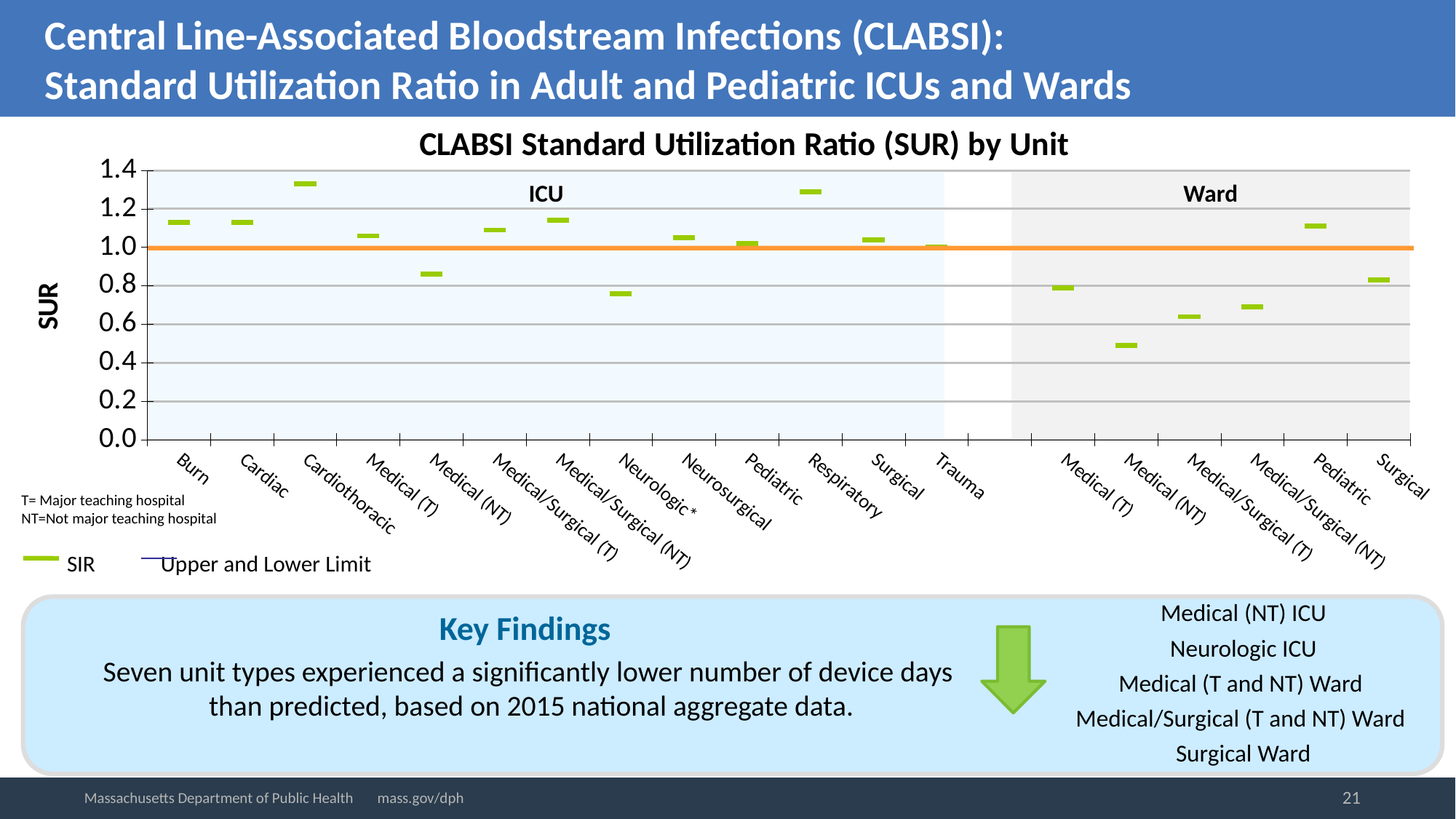
How many unit types are plotted in the chart in total? 19 Which unit has the highest SUR in the chart? Cardiothoracic (ICU) Is the SUR for the Pediatric Ward greater or less than 1.0? greater Which has a higher SUR: the Pediatric Ward or the Surgical Ward? Pediatric Ward How many entries does the chart legend list? 2 What is the label on the vertical axis of the chart? SUR Is the SUR for the Medical (NT) Ward greater or less than 0.6? less How many ICU unit types are plotted in the chart? 13 Which unit has the lowest SUR in the chart? Medical (NT) Ward Is the SUR for the Neurologic ICU greater or less than 0.8? less Which has a higher SUR: the Neurologic ICU or the Medical (NT) ICU? Medical (NT) ICU